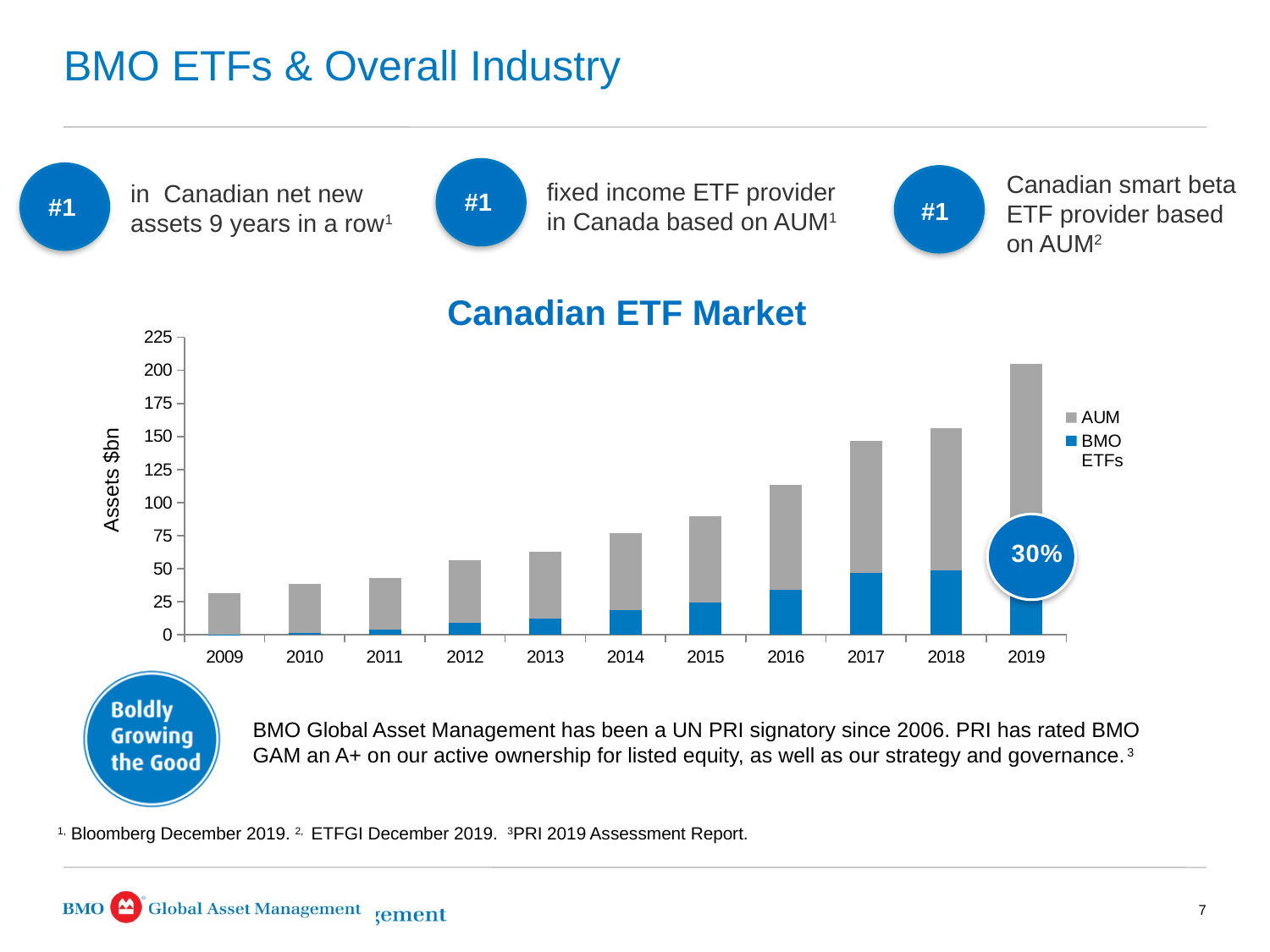
Which year has the tallest total bar in the Canadian ETF Market chart? 2019 What percentage is shown in the callout next to the 2019 bar in the Canadian ETF Market chart? 30% Do the total bar heights in the Canadian ETF Market chart rise or fall from 2009 to 2019? Rise Is the total bar for 2019 in the Canadian ETF Market chart greater or less than 175? greater How many years are shown on the x axis of the Canadian ETF Market chart? 11 Which year has the larger total bar in the Canadian ETF Market chart, 2018 or 2019? 2019 Is the total bar for 2009 in the Canadian ETF Market chart greater or less than 50? less Which year has the shortest total bar in the Canadian ETF Market chart? 2009 Is the BMO ETFs value for 2014 in the Canadian ETF Market chart greater or less than 25? less How many series does the legend of the Canadian ETF Market chart list? 2 What is the label on the y axis of the Canadian ETF Market chart? Assets $bn What kind of chart is the Canadian ETF Market chart? Stacked bar chart